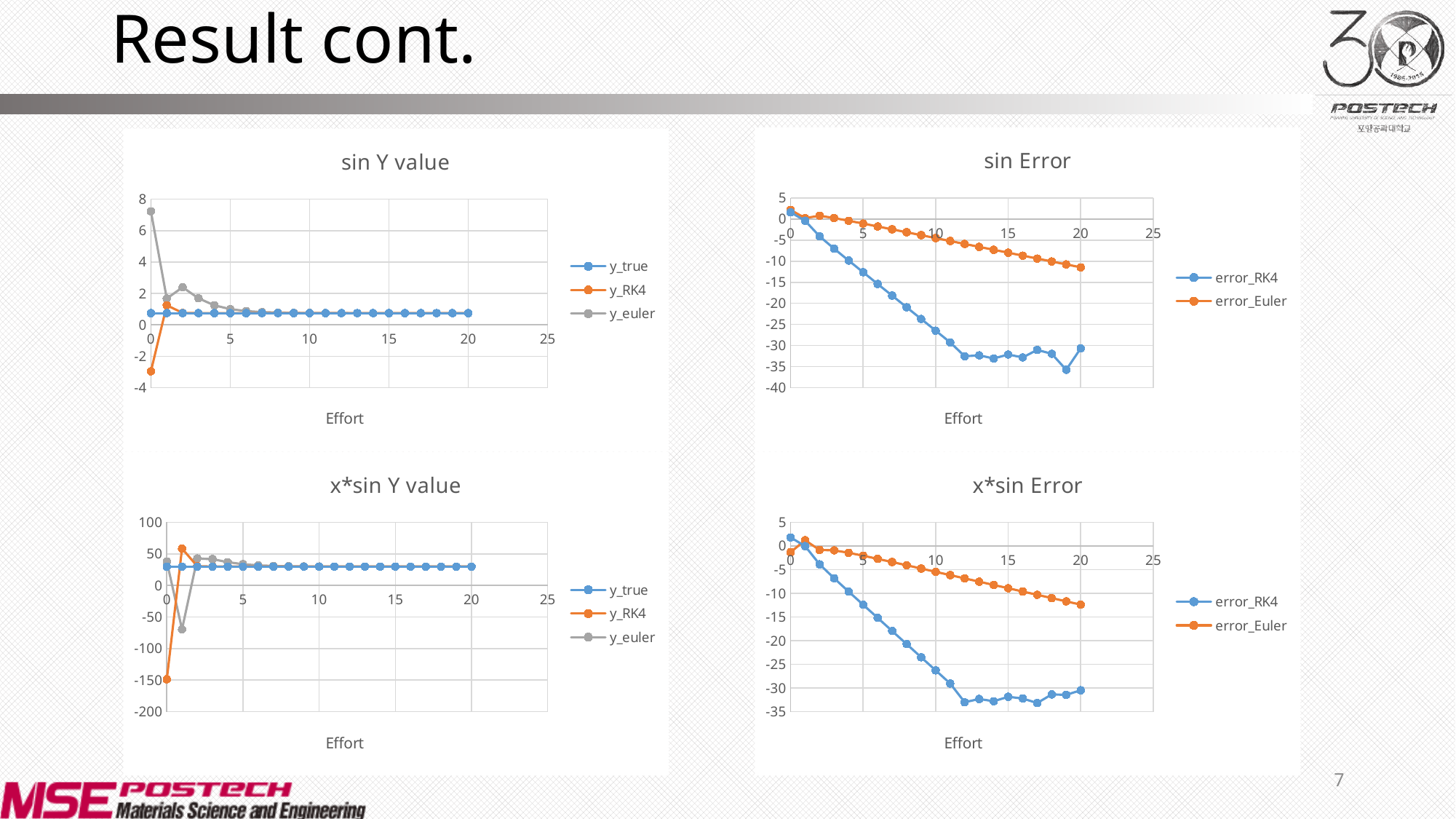
What kind of chart is the "sin Y value" chart? line chart In the "x*sin Y value" chart, which series has the larger value at Effort 1, y_RK4 or y_euler? y_RK4 How many series does the legend of the "sin Error" chart list? 2 What are the legend entries of the "x*sin Error" chart? error_RK4, error_Euler In the "x*sin Error" chart, does the error_Euler series rise or fall as Effort increases? fall In the "sin Error" chart, does the error_RK4 series rise or fall overall as Effort increases from 0 to 20? fall In the "sin Error" chart, which series has the larger value at Effort 20, error_RK4 or error_Euler? error_Euler In the "sin Error" chart, is the error_RK4 value at Effort 12 greater or less than -30? less In the "sin Y value" chart, is the y_euler value at Effort 0 greater or less than 6? greater In the "x*sin Y value" chart, is the y_RK4 value at Effort 0 greater or less than -100? less How many series does the legend of the "sin Y value" chart list? 3 What is the x-axis title of the "x*sin Y value" chart? Effort